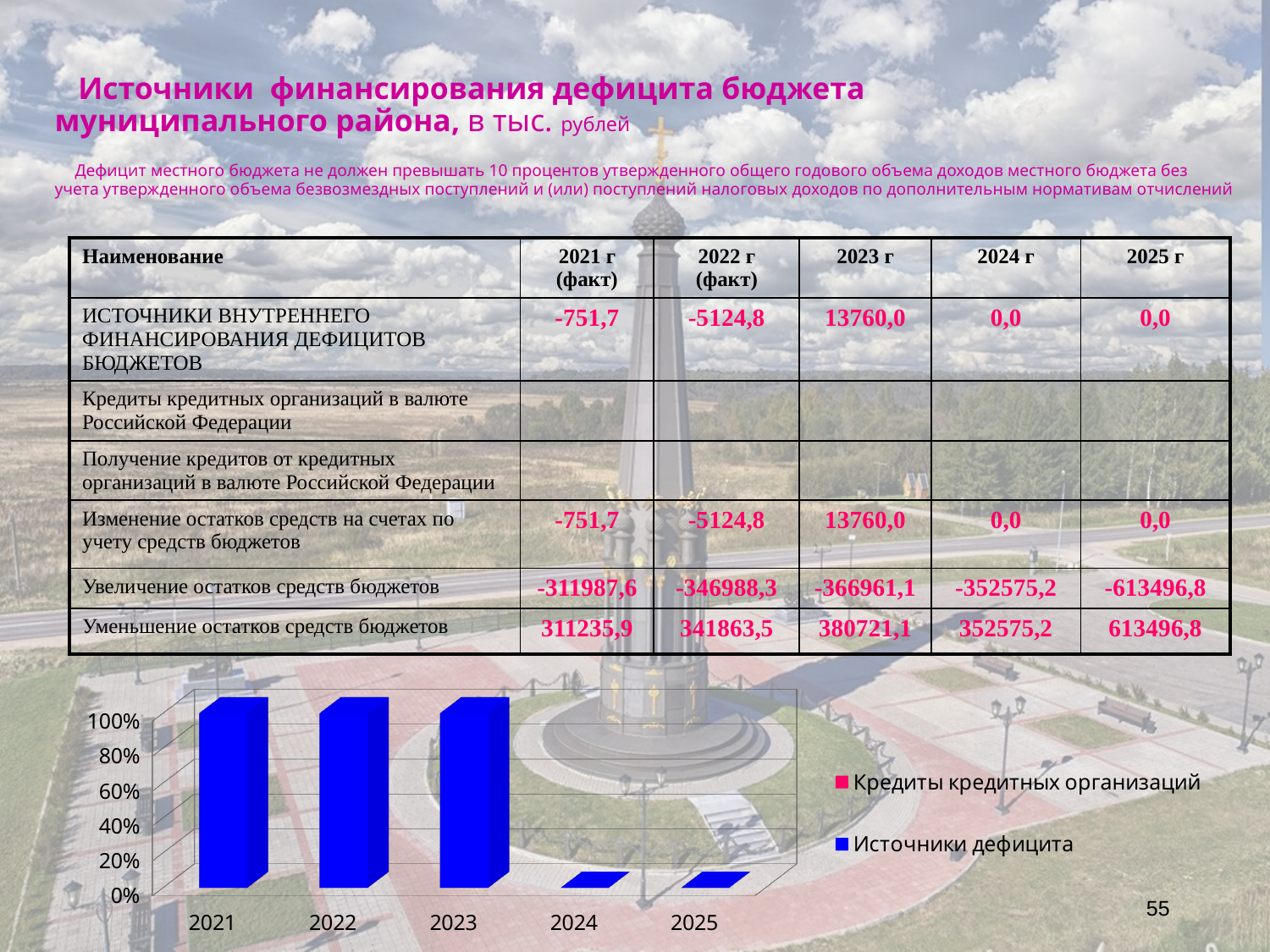
What kind of chart is shown at the bottom of the slide? bar chart How many series does the legend of the bar chart list? 2 Is the value of the Источники дефицита bar for 2021 greater or less than 80%? greater What are the two legend entries of the bar chart? Кредиты кредитных организаций; Источники дефицита In the bar chart, which year has the larger Источники дефицита bar, 2025 or 2023? 2023 Do the Источники дефицита bars rise or fall from 2023 to 2024 in the bar chart? fall How many years are shown on the x axis of the bar chart? 5 Which series in the bar chart is shown in blue? Источники дефицита In the bar chart, which year has the larger Источники дефицита bar, 2022 or 2024? 2022 Is the value of the Источники дефицита bar for 2025 greater or less than 20%? less Is the value of the Источники дефицита bar for 2023 greater or less than 60%? greater